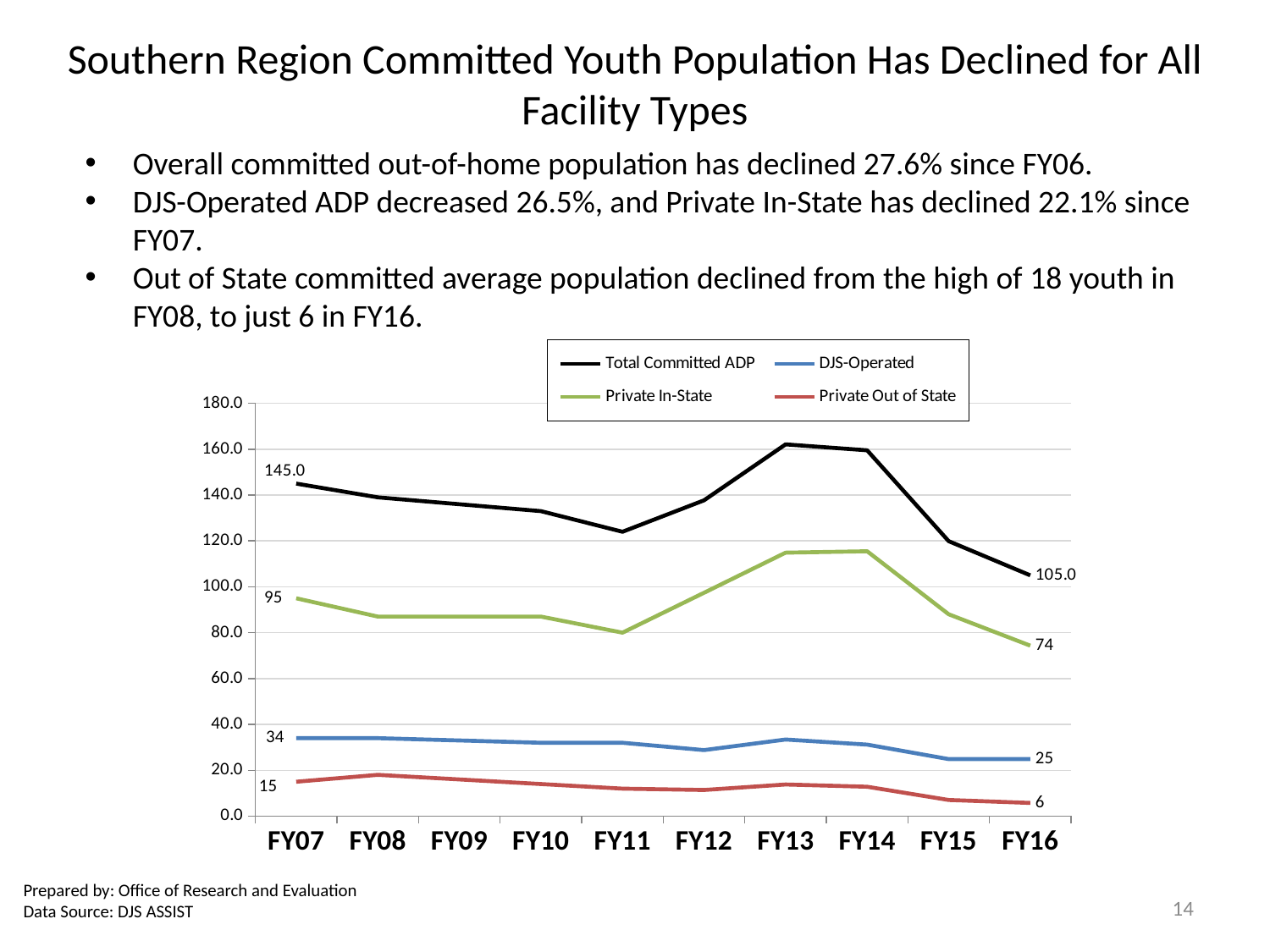
What is the Private In-State value for FY16? 74 Is the Private In-State value for FY13 greater or less than 100? greater What is the Total Committed ADP value for FY07? 145.0 Does the Private Out of State line rise or fall overall from FY07 to FY16? fall How many series does the legend list? 4 What type of chart is shown on the slide? line chart What is the Private Out of State value for FY07? 15 Which is larger, the DJS-Operated value in FY07 or in FY16? FY07 In which fiscal year does the Total Committed ADP line reach its highest point? FY13 How many fiscal years are plotted along the x axis? 10 By how much did Total Committed ADP decline from FY07 to FY16? 40.0 What is the Total Committed ADP value for FY16? 105.0